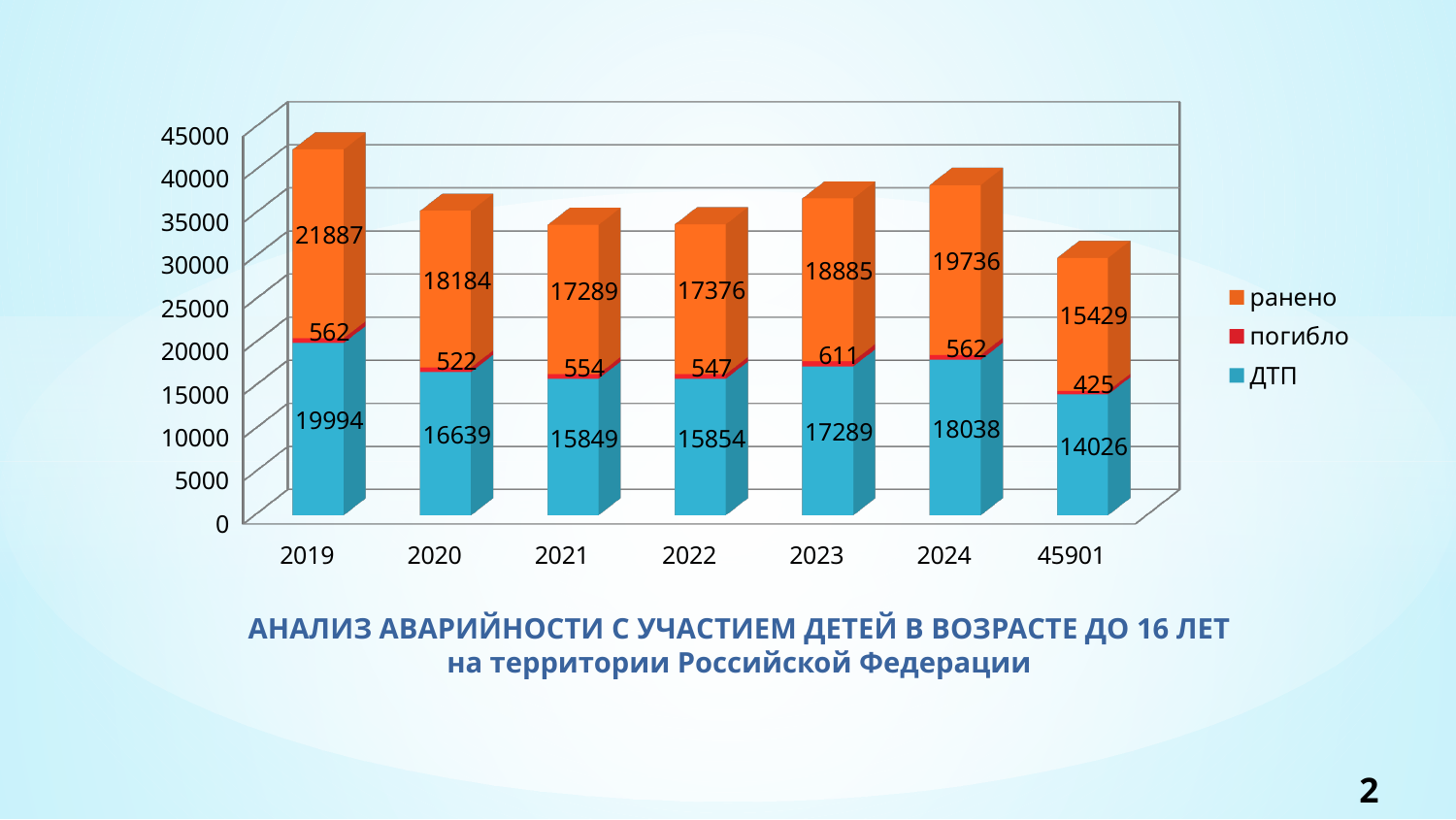
What is the total of the stacked bar for 2020? 35345 What is the value of ДТП for 2019? 19994 How many categories are shown on the x axis? 7 What is the difference between the ДТП values for 2024 and 2023? 749 What is the value of ранено for the category labelled 45901? 15429 Which is larger, the ранено value for 2021 or for 2022? 2022 What kind of chart is shown on the slide? Stacked bar chart Which year has the highest value for ранено? 2019 How many series does the legend list? 3 What is the value of погибло for 2023? 611 Which category has the lowest value for ДТП? 45901 What is the value of ранено for 2024? 19736